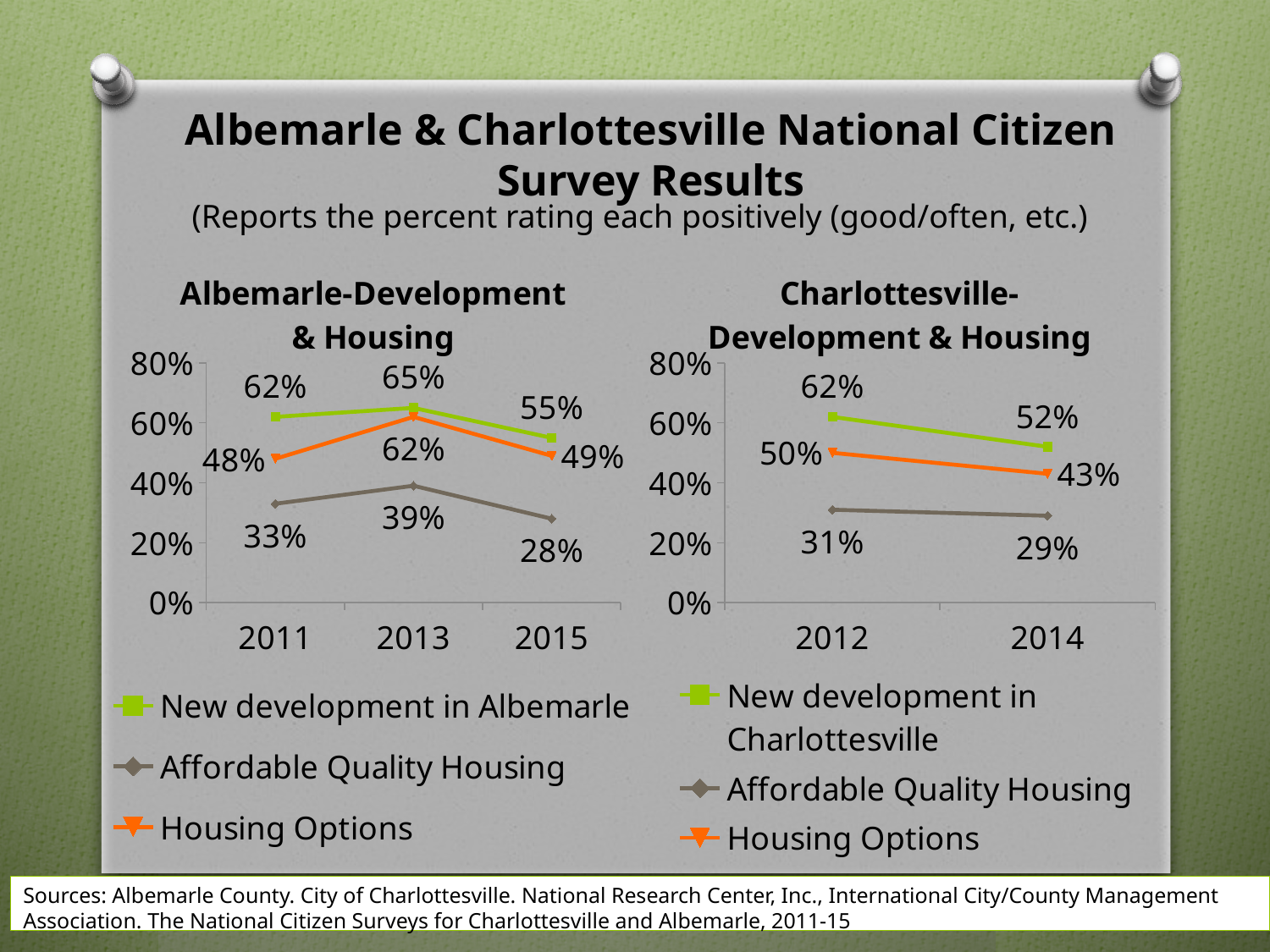
What kind of chart is the Albemarle-Development & Housing chart? line chart In the Albemarle-Development & Housing chart, what is the value for New development in Albemarle in 2013? 65% In the Charlottesville-Development & Housing chart, what is the value for Affordable Quality Housing in 2012? 31% In the Albemarle-Development & Housing chart, which is larger in 2015: New development in Albemarle or Housing Options? New development in Albemarle In the Charlottesville-Development & Housing chart, what is the value for Housing Options in 2014? 43% In the Albemarle-Development & Housing chart, what is the difference between New development in Albemarle and Housing Options in 2011? 14% In the Charlottesville-Development & Housing chart, what is the difference between New development in Charlottesville in 2012 and in 2014? 10% In the Albemarle-Development & Housing chart, in which year is Housing Options highest? 2013 In the Albemarle-Development & Housing chart, in which year is Affordable Quality Housing lowest? 2015 In the Charlottesville-Development & Housing chart, does Housing Options rise or fall from 2012 to 2014? fall In the Albemarle-Development & Housing chart, what is the value for Affordable Quality Housing in 2015? 28% How many series does the legend of the Charlottesville-Development & Housing chart list? 3